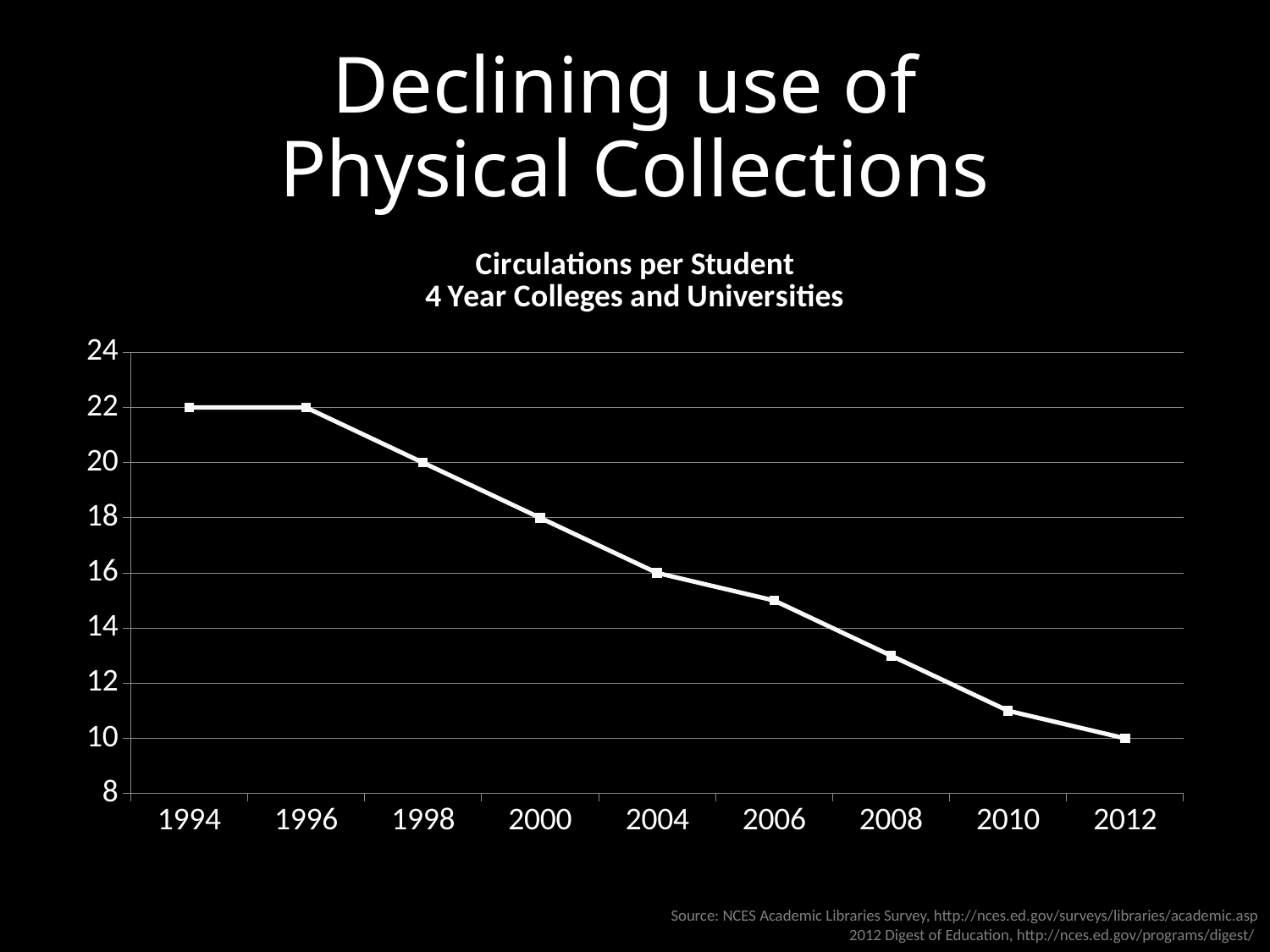
What kind of chart is shown on the slide? line chart What is the value for 2012? 10 What is the value for 1998? 20 Do the values rise or fall from 1994 to 2012? fall What is the value for 1994? 22 Is the value for 2010 greater or less than 12? less What is the difference between the value for 1996 and the value for 2012? 12 How many data points are plotted on the line? 9 Which year has the lowest value? 2012 Is the value for 2006 greater or less than 14? greater What is the title of the chart? Circulations per Student 4 Year Colleges and Universities What is the value for 2004? 16